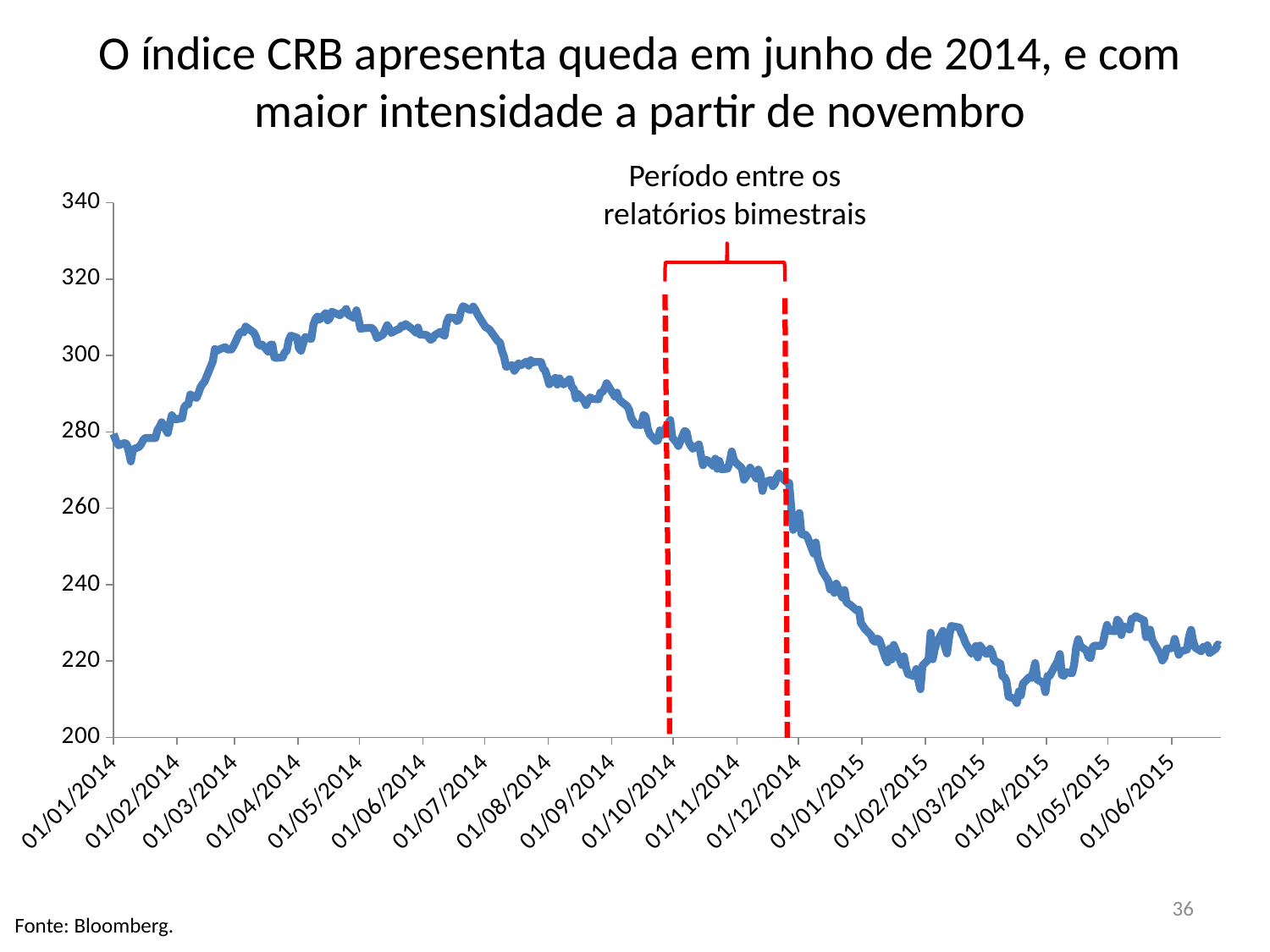
Is the value at 01/02/2015 greater or less than 240? less What kind of chart is shown on the slide? line chart Is the lowest value reached by the line greater or less than 220? less Is the highest value reached by the line greater or less than 300? greater What source is cited for the chart data? Bloomberg What is the title of the slide's chart? O índice CRB apresenta queda em junho de 2014, e com maior intensidade a partir de novembro Does the line rise or fall between 01/07/2014 and 01/01/2015? fall How many date labels are shown on the x axis? 18 Does the line rise or fall between 01/01/2014 and 01/05/2014? rise Which is larger, the value at 01/05/2014 or the value at 01/05/2015? 01/05/2014